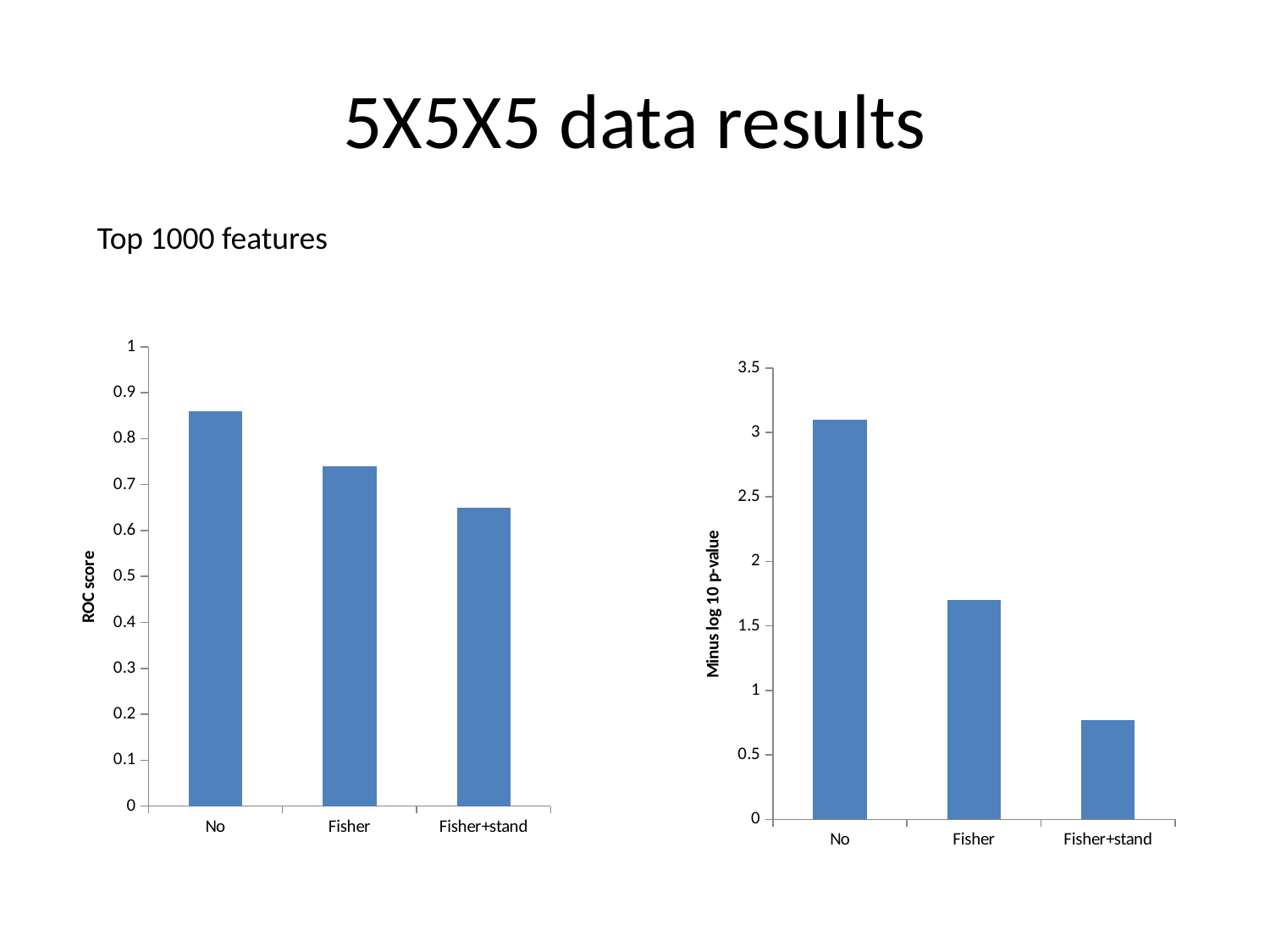
In the left chart (ROC score), which category has the lowest bar? Fisher+stand In the left chart (ROC score), is the value for Fisher+stand greater or less than 0.7? less What is the label on the vertical axis of the right chart? Minus log 10 p-value What kind of chart is the left chart with the ROC score axis? bar chart In the right chart (Minus log 10 p-value), which category has the highest bar? No In the right chart (Minus log 10 p-value), is the value for No greater or less than 3? greater In the right chart (Minus log 10 p-value), which category has the lowest bar? Fisher+stand In the right chart (Minus log 10 p-value), do the values rise or fall from No to Fisher+stand along the x axis? fall In the left chart (ROC score), how many categories are shown on the x axis? 3 In the right chart (Minus log 10 p-value), is the value for Fisher+stand greater or less than 1? less In the left chart (ROC score), which category has the highest bar? No